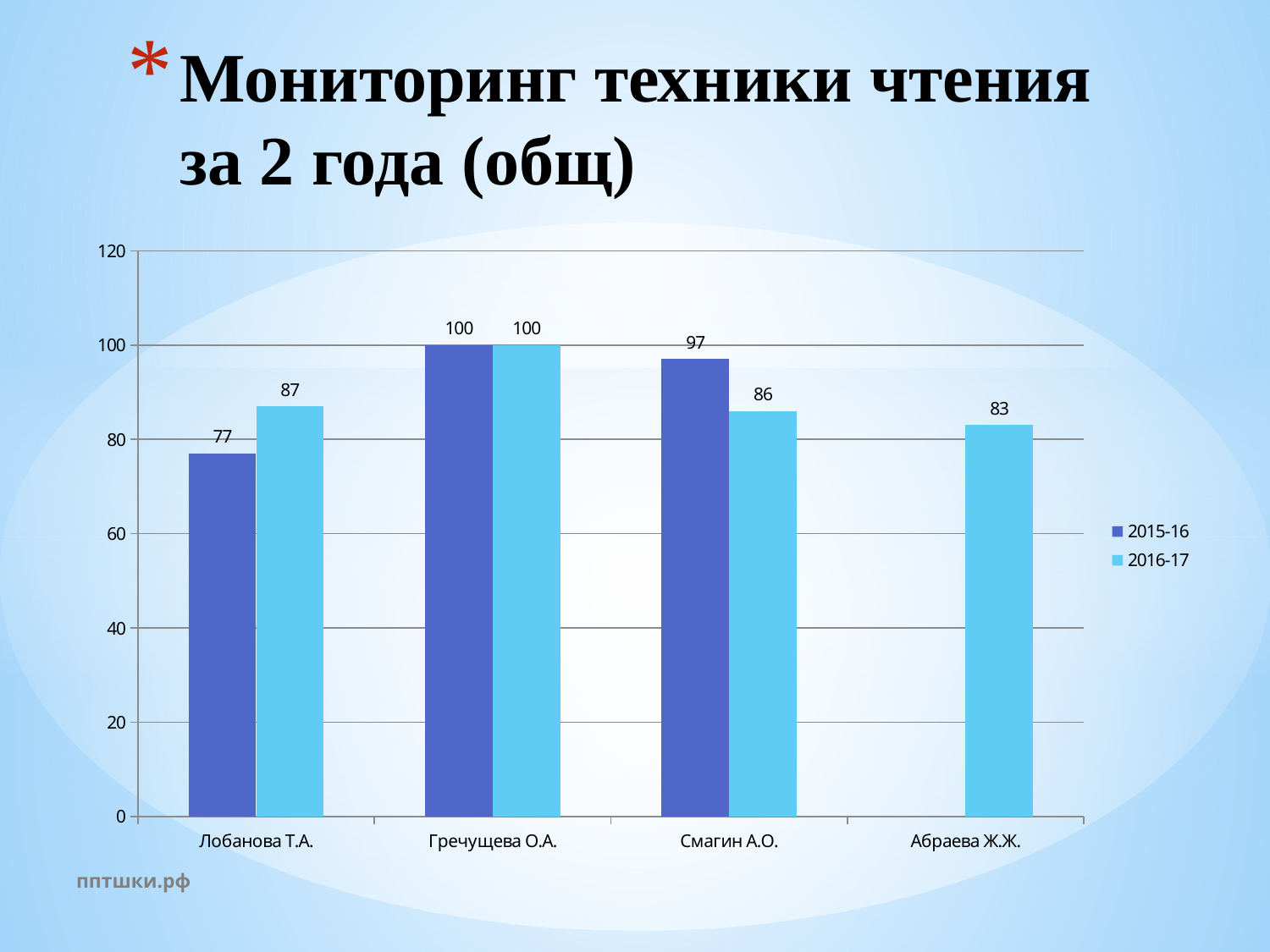
What is the difference between the 2015-16 and 2016-17 values for Лобанова Т.А.? 10 What is the value for Лобанова Т.А. in the 2015-16 series? 77 What is the value for Лобанова Т.А. in the 2016-17 series? 87 What kind of chart is shown on the slide? bar chart What is the value for Смагин А.О. in the 2016-17 series? 86 How many series does the legend list? 2 What is the value for Абраева Ж.Ж. in the 2016-17 series? 83 Which category has the highest value in the 2016-17 series? Гречущева О.А. How many categories are shown on the x axis? 4 Which category has the lowest value in the 2015-16 series? Лобанова Т.А. Which is larger for Смагин А.О.: the 2015-16 value or the 2016-17 value? 2015-16 What is the title of the slide? Мониторинг техники чтения за 2 года (общ)